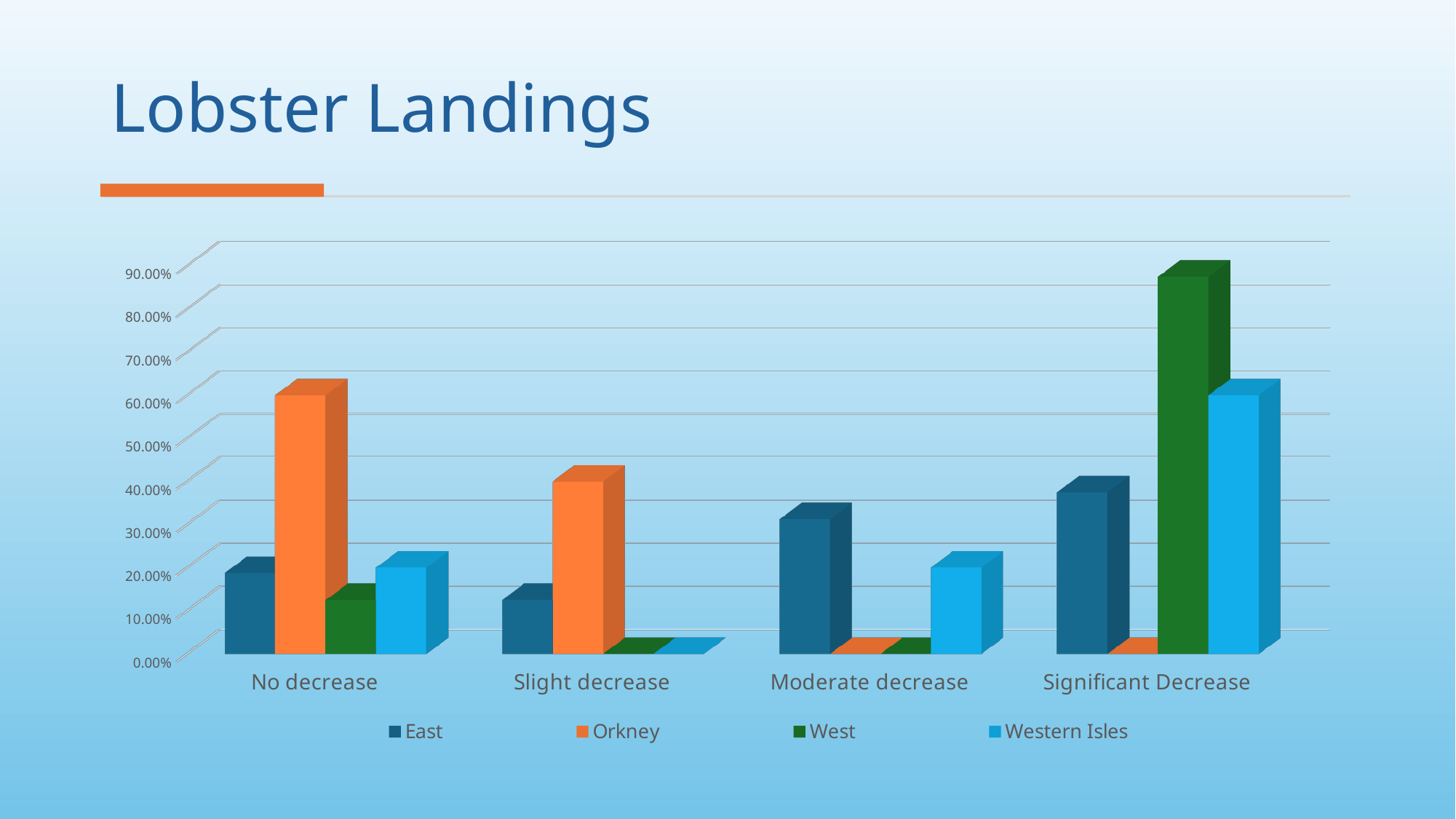
Which series has the highest value in the No decrease category? Orkney Which series has the highest value in the Significant Decrease category? West Which is larger: the Orkney value for No decrease or the Orkney value for Slight decrease? No decrease What is the title of the slide? Lobster Landings How many categories are shown on the x axis? 4 Is the value for East in the Slight decrease category greater or less than 20.00%? less What kind of chart is shown on the slide? bar chart Is the value for Orkney in the No decrease category greater or less than 50.00%? greater How many series does the legend list? 4 Which is larger: the Western Isles value for Significant Decrease or the East value for Significant Decrease? Western Isles Which series has the highest value in the Moderate decrease category? East Is the value for West in the Significant Decrease category greater or less than 80.00%? greater